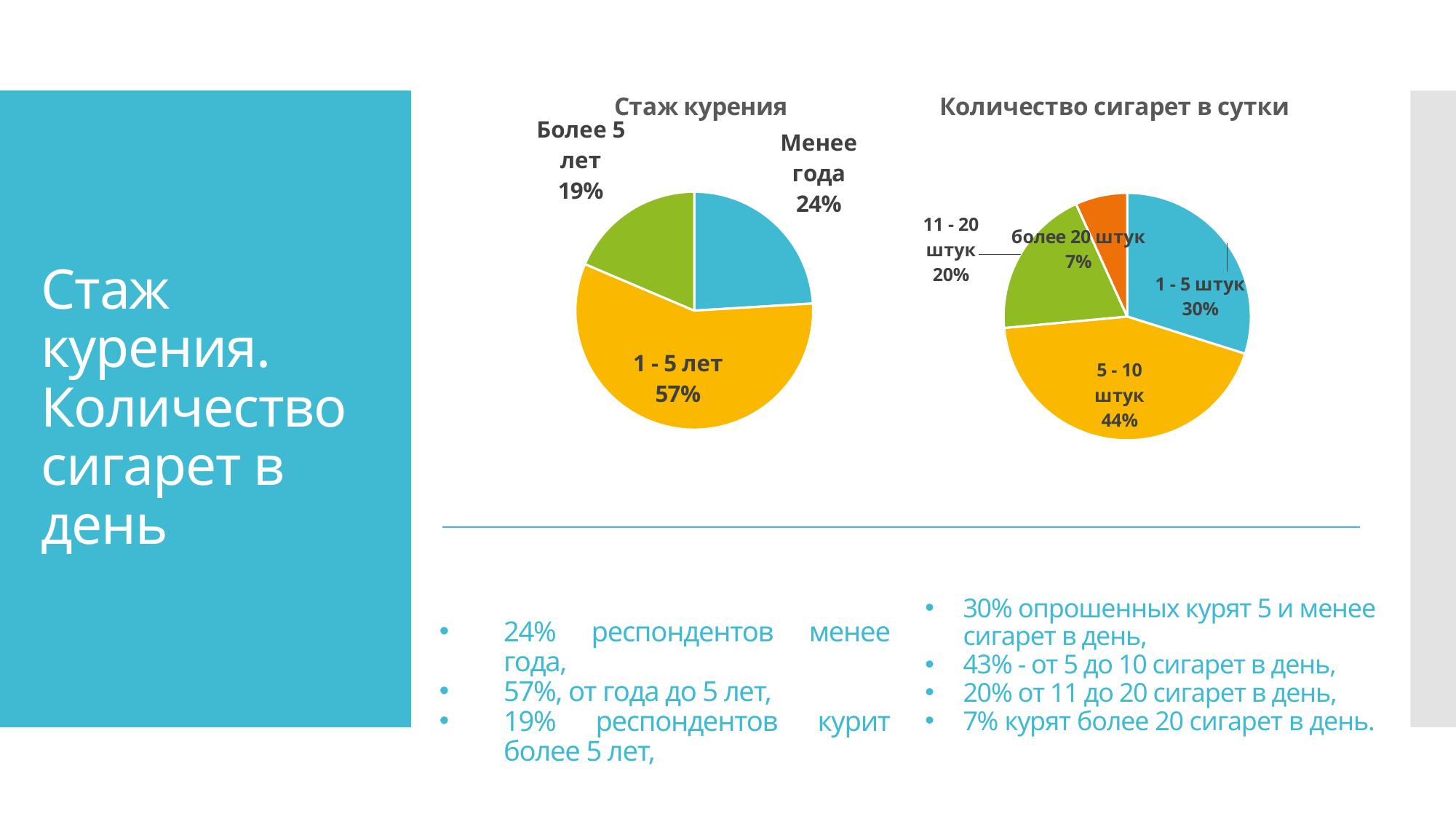
In the "Количество сигарет в сутки" chart, which is larger: the share for "1 - 5 штук" or for "11 - 20 штук"? 1 - 5 штук In the "Количество сигарет в сутки" chart, what share is labelled for "более 20 штук"? 7% In the "Количество сигарет в сутки" chart, which category has the largest slice? 5 - 10 штук In the "Количество сигарет в сутки" chart, what share is labelled for "5 - 10 штук"? 44% In the "Количество сигарет в сутки" chart, how many categories are shown? 4 In the "Количество сигарет в сутки" chart, what colour is the "более 20 штук" slice? Orange What type of chart is the "Стаж курения" chart? Pie chart In the "Стаж курения" chart, what share is labelled for "Менее года"? 24% In the "Стаж курения" chart, how many slices does the pie have? 3 In the "Стаж курения" chart, what is the difference between the shares for "1 - 5 лет" and "Менее года"? 33% In the "Стаж курения" chart, which category has the smallest slice? Более 5 лет In the "Стаж курения" chart, what share is labelled for "1 - 5 лет"? 57%